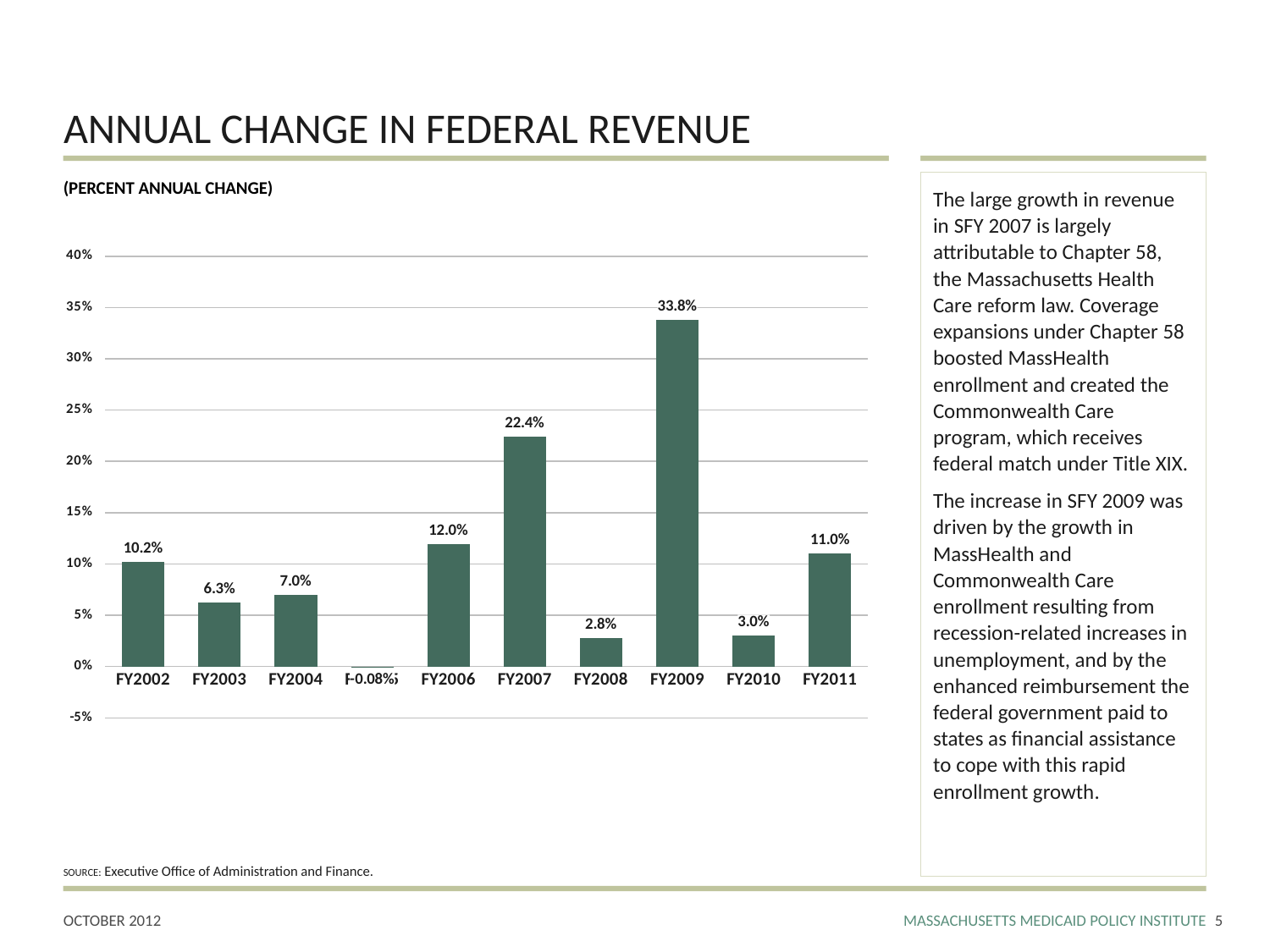
What is the annual change in federal revenue for FY2009? 33.8% What is the difference between the values for FY2009 and FY2007? 11.4 percentage points What is the annual change in federal revenue for FY2002? 10.2% What is the value shown for FY2007? 22.4% What kind of chart is shown on the slide? Bar chart What is the title of the chart? Annual Change in Federal Revenue Which is larger, the value for FY2006 or the value for FY2004? FY2006 Which fiscal year has the highest annual change in federal revenue? FY2009 What is the difference between the values for FY2002 and FY2003? 3.9 percentage points Is the value for FY2007 greater or less than 20%? greater How many fiscal years are shown on the x axis? 10 What value is labeled on the FY2011 bar? 11.0%